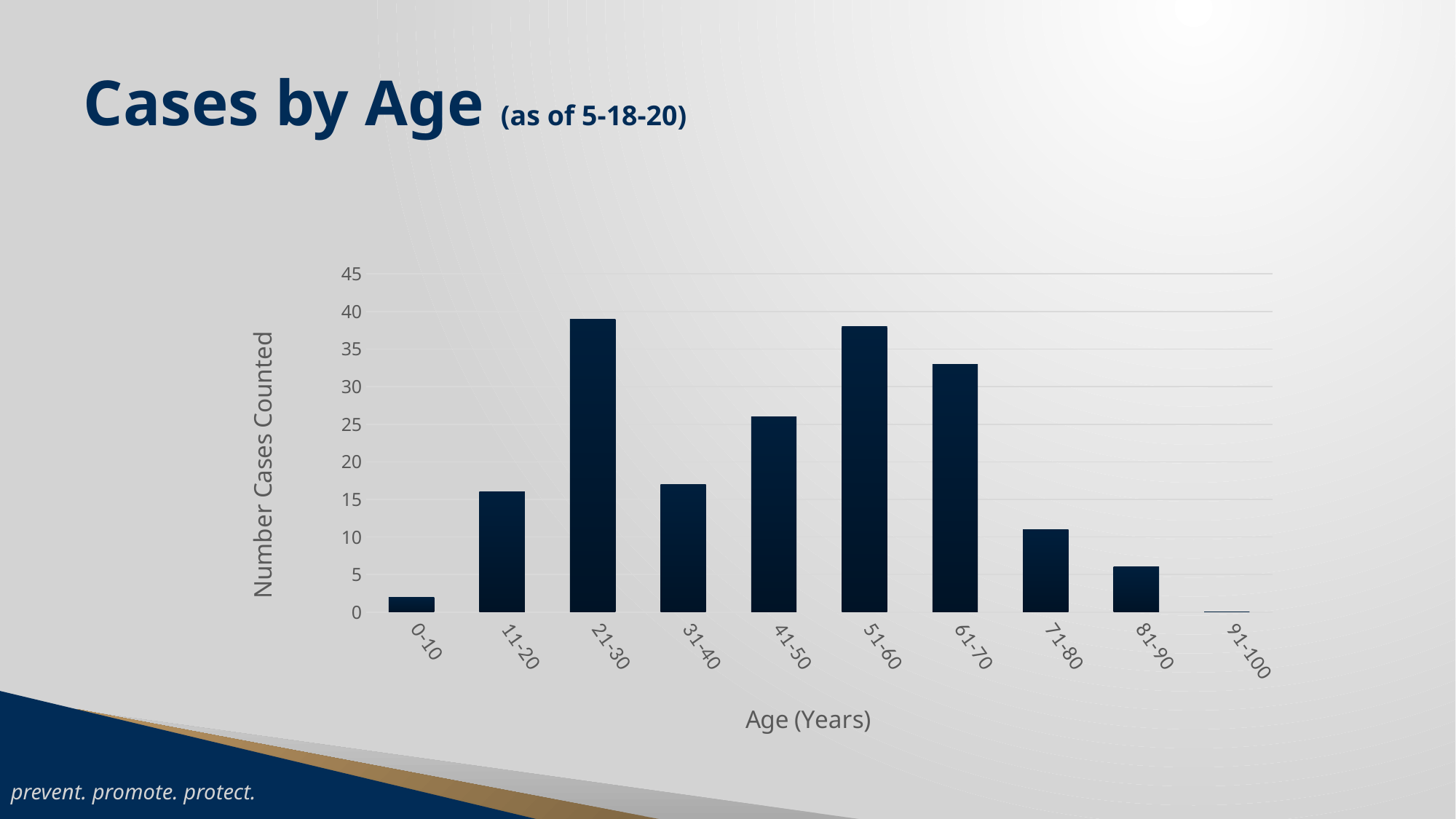
How many age groups are shown on the x axis of the chart? 10 What is the title of the y axis of the chart? Number Cases Counted Which age group has more cases counted, 61-70 or 41-50? 61-70 Is the number of cases for the 61-70 age group greater or less than 30? greater Which age group has the lowest number of cases counted? 91-100 Which age group has more cases counted, 11-20 or 71-80? 11-20 Is the number of cases for the 31-40 age group greater or less than 20? less As of what date is the data in the chart reported, according to the slide title? 5-18-20 Is the number of cases for the 81-90 age group greater or less than 10? less What kind of chart is shown on the slide? bar chart